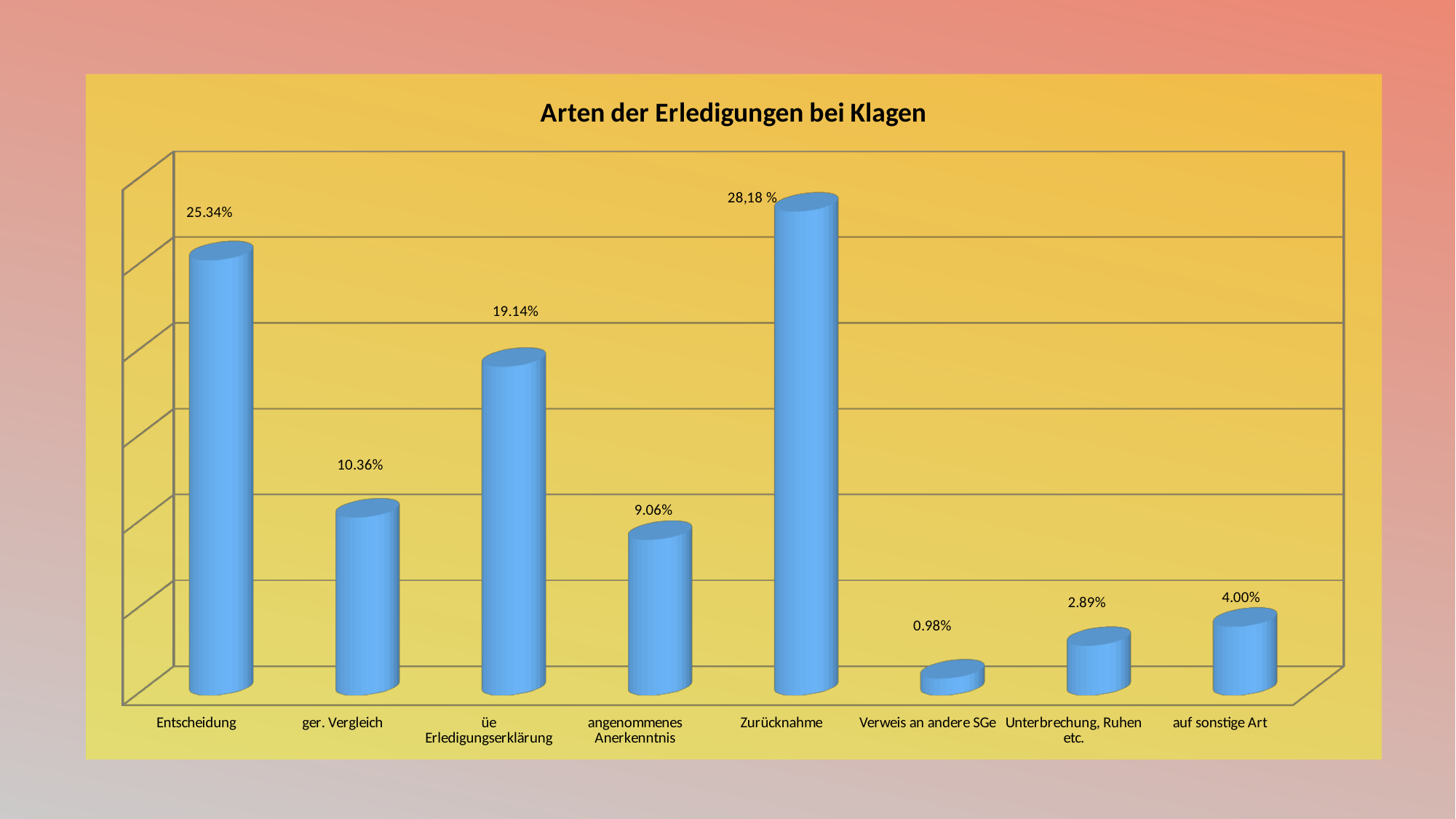
What is the value for ger. Vergleich? 10.36% What is the difference between the values for Entscheidung and ger. Vergleich? 14.98% What kind of chart is shown on the slide? Bar chart What is the value for auf sonstige Art? 4.00% What is the value for Zurücknahme? 28,18 % Which category has the lowest value? Verweis an andere SGe Which is larger, the value for Unterbrechung, Ruhen etc. or the value for auf sonstige Art? auf sonstige Art What is the difference between the values for üe Erledigungserklärung and angenommenes Anerkenntnis? 10.08% What is the value for Verweis an andere SGe? 0.98% How many categories are shown in the chart? 8 What is the value for Entscheidung? 25.34% Which category has the highest value? Zurücknahme